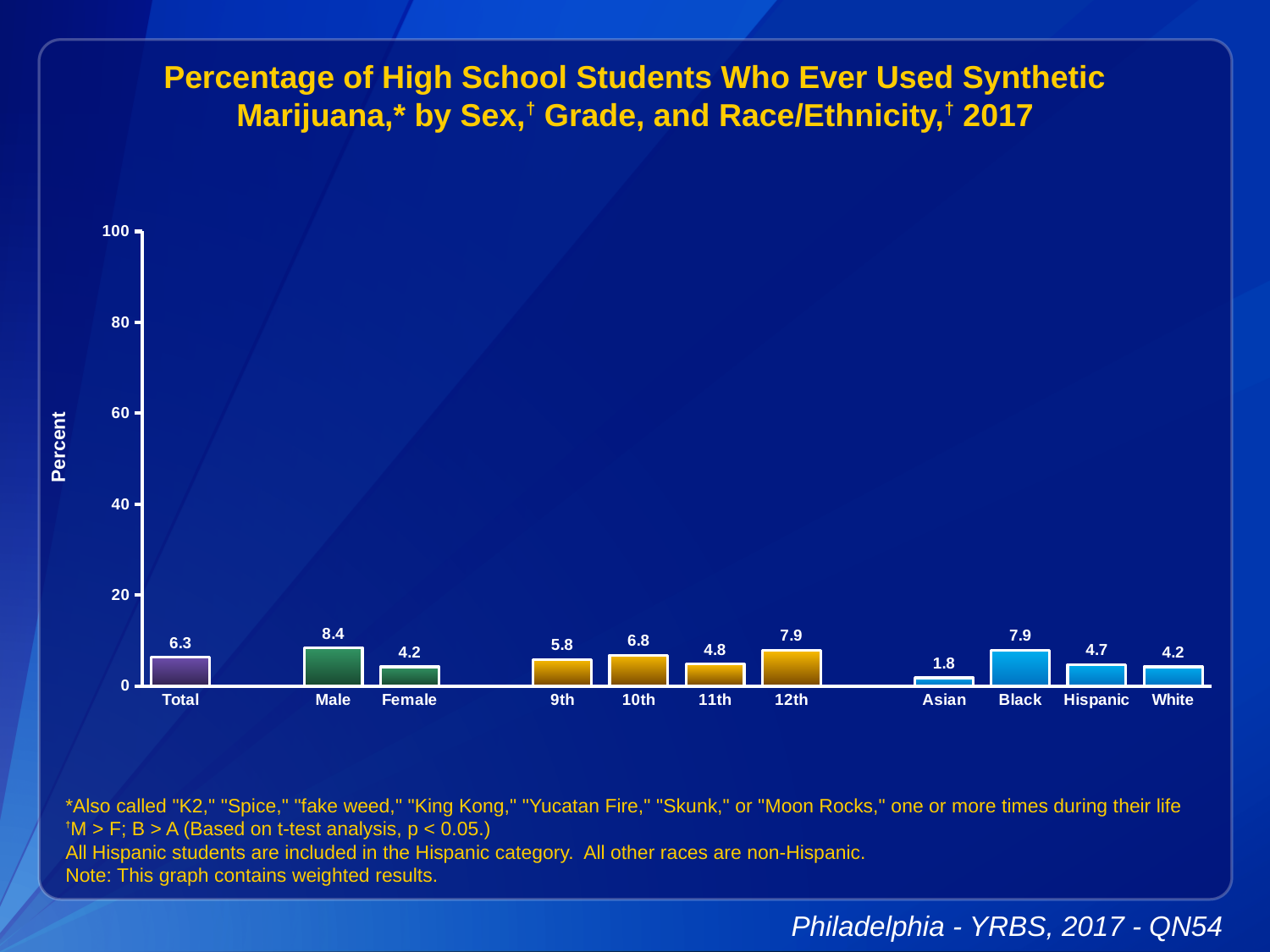
How many categories are shown on the x axis? 11 What kind of chart is this? bar chart Which category has the highest value? Male Is the value for Black greater or less than 20? less What is the value for Asian? 1.8 What is the difference between the values for Male and Female? 4.2 What is the label on the y axis? Percent Which category has the lowest value? Asian What is the value for 10th grade? 6.8 What is the value for Male? 8.4 Which is larger, the value for 9th grade or the value for 11th grade? 9th What is the value for Total? 6.3